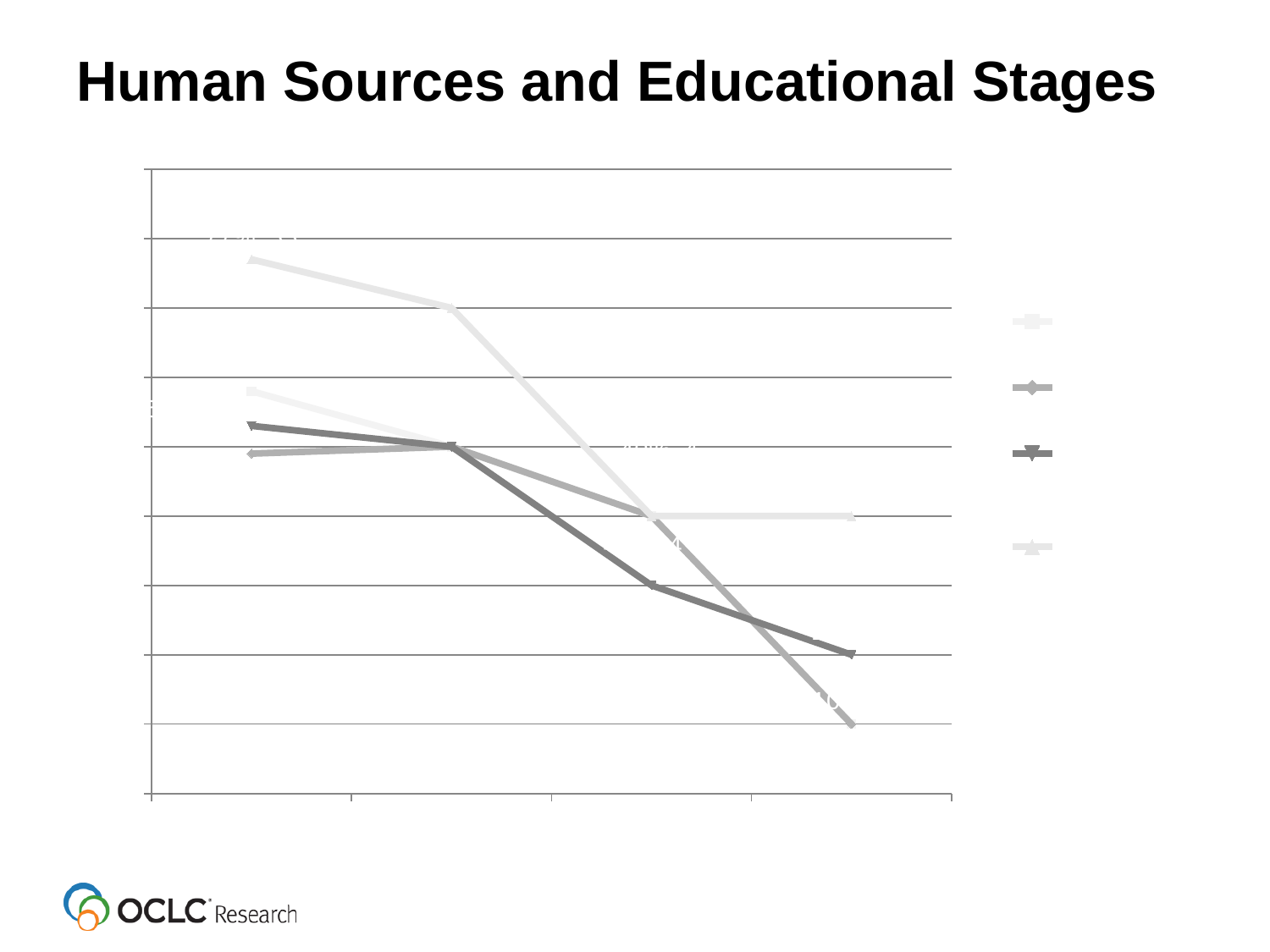
Overall, do the plotted values rise or fall from left to right along the x axis? fall What is the title of the slide's chart? Human Sources and Educational Stages How many lines are plotted on the chart? 4 How many data points does each line have along the x axis? 4 What kind of chart is shown on the slide? line chart How many series does the legend list? 4 Does the topmost line at the left of the chart rise or fall from its first point to its last point? fall